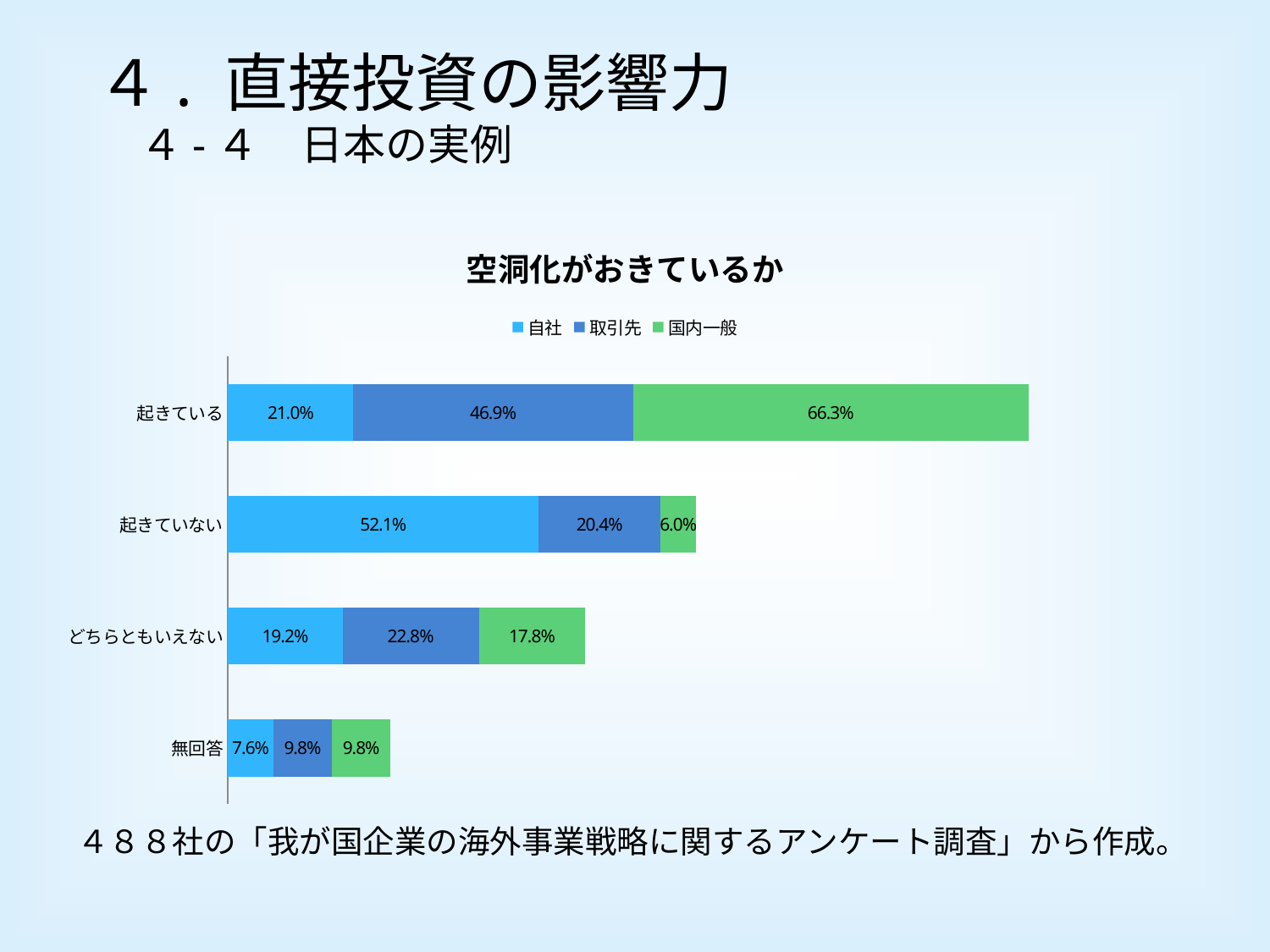
Which category has the lowest value for 自社? 無回答 What type of chart is shown on the slide? Stacked bar chart What is the value for 国内一般 in the 起きている category? 66.3% What is the value for 自社 in the 起きていない category? 52.1% How many categories are shown on the chart? 4 What is the difference between the 自社 values for 起きていない and 起きている? 31.1% What is the total of the stacked bar for 無回答? 27.2% How many series does the legend list? 3 Which category has the highest value for 国内一般? 起きている Which is larger: the 取引先 value for 起きている or the 取引先 value for 起きていない? 起きている What is the value for 取引先 in the どちらともいえない category? 22.8% What is the title of the chart? 空洞化がおきているか